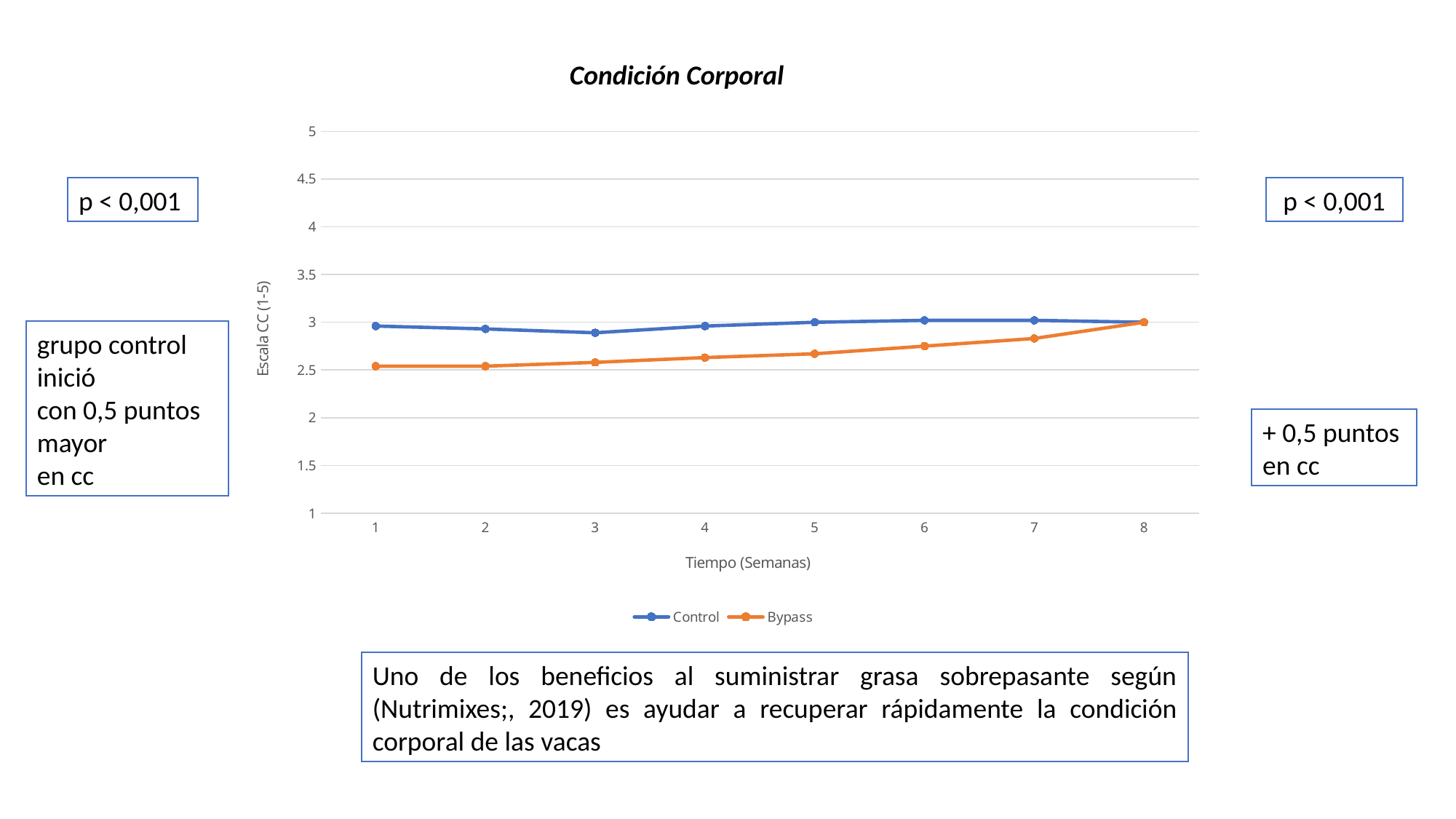
Is the value for Bypass at week 7 greater or less than 3? less What kind of chart is shown on the slide? line chart Which series is drawn in orange? Bypass How many weeks (points) are plotted along the x axis for each series? 8 Is the value for Bypass at week 4 greater or less than 2.5? greater What is the title of the chart? Condición Corporal Does the Bypass series rise or fall from week 1 to week 8? rise How many series does the chart legend list? 2 Is the value for Bypass at week 1 greater or less than 3? less At week 1, which series has the higher value, Control or Bypass? Control At week 3, which series has the higher value, Control or Bypass? Control